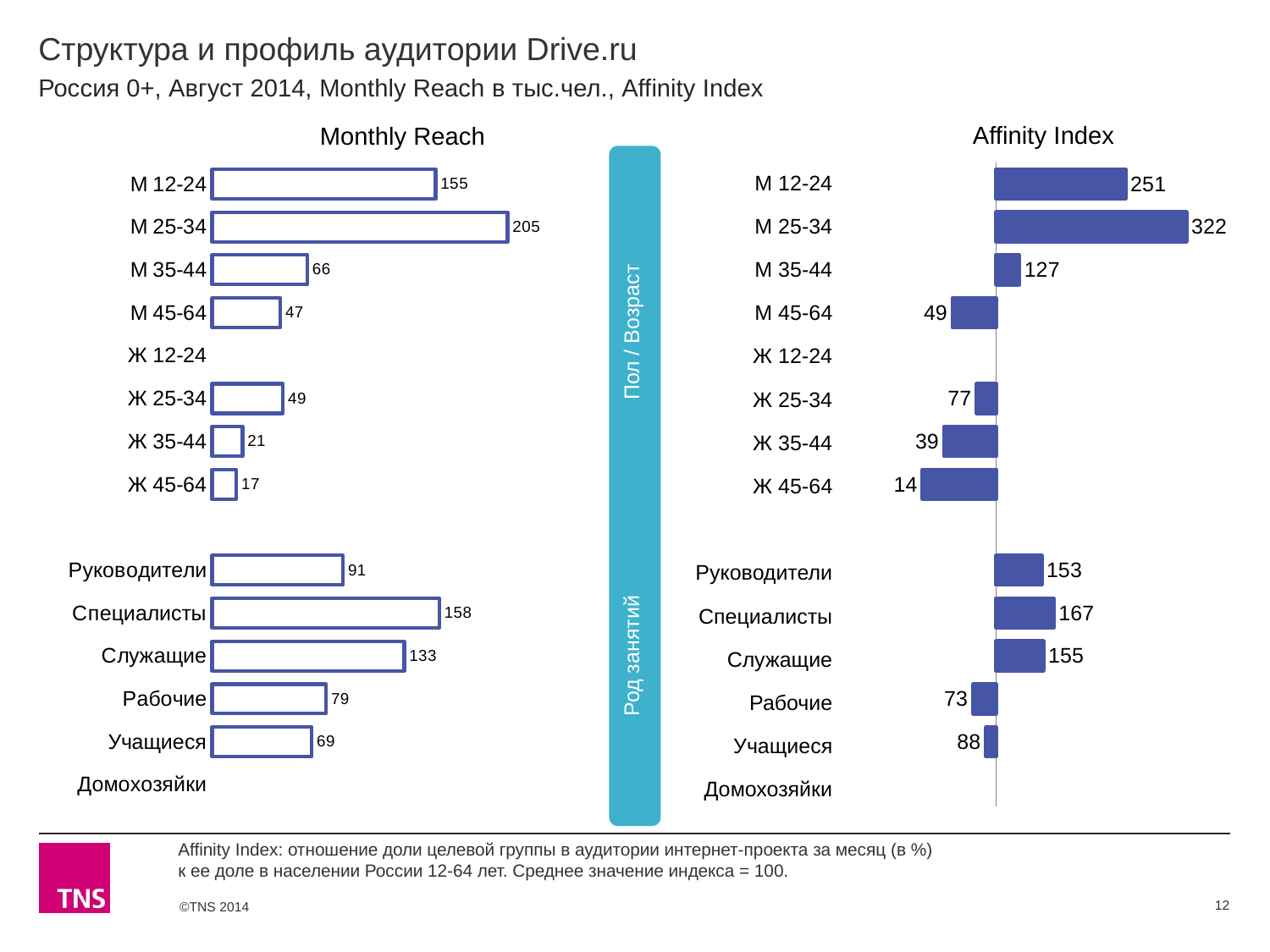
In the Affinity Index chart, which category has the lowest labelled value? Ж 45-64 In the Affinity Index chart, which is larger: Руководители or Служащие? Служащие In the Affinity Index chart, what is the value for Учащиеся? 88 In the Monthly Reach chart, which is larger: Рабочие or Учащиеся? Рабочие In the Monthly Reach chart, which category has the highest value? М 25-34 In the Monthly Reach chart, what is the value for М 25-34? 205 What kind of chart is the Affinity Index chart? Bar chart In the Monthly Reach chart, what is the value for Ж 35-44? 21 In the Affinity Index chart, what is the difference between М 25-34 and М 12-24? 71 In the Monthly Reach chart, how many categories are listed under Род занятий? 6 In the Monthly Reach chart, what is the difference between Специалисты and Служащие? 25 In the Affinity Index chart, what is the value for Ж 45-64? 14